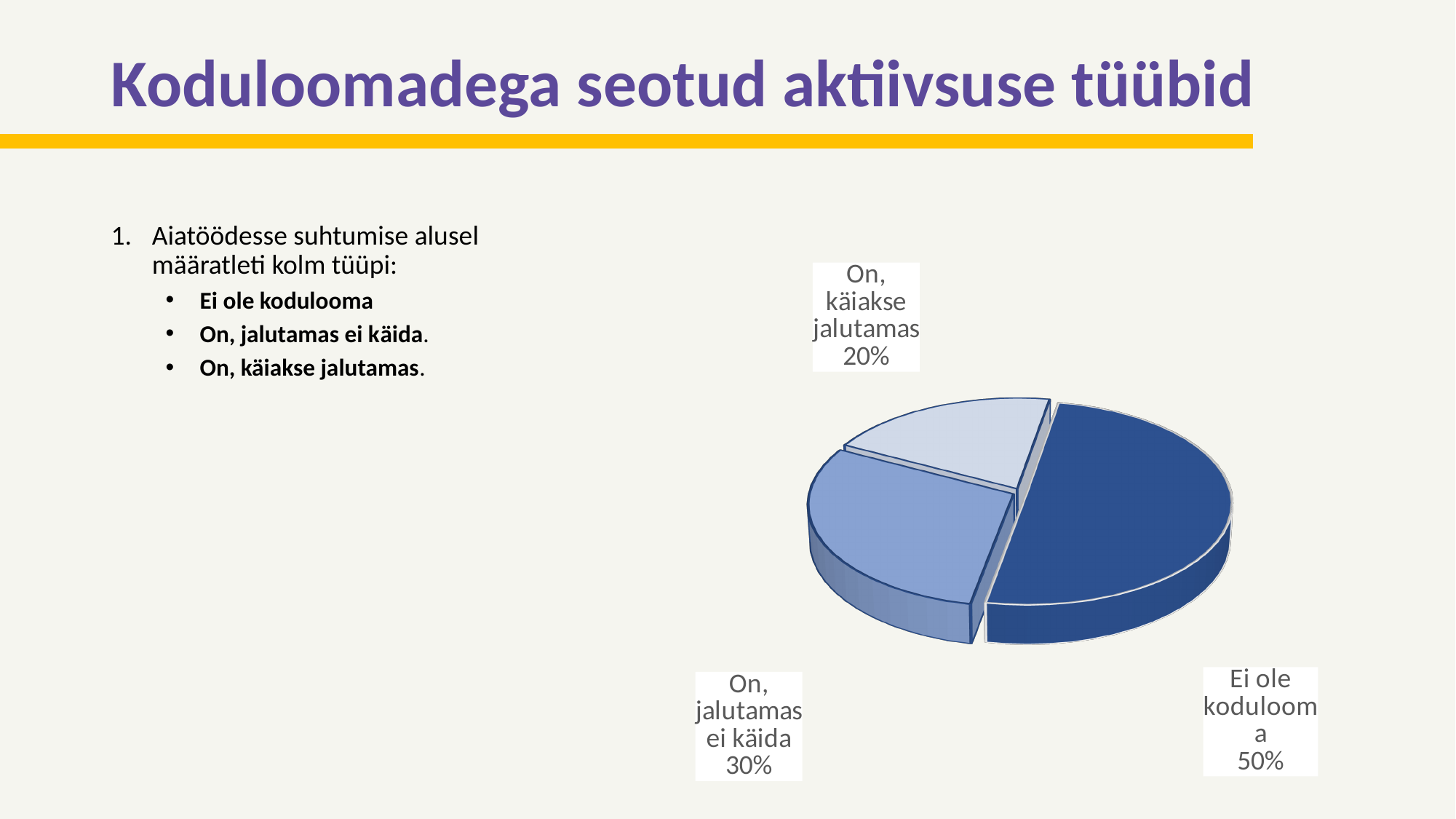
What share of the pie does "Ei ole kodulooma" have? 50% What kind of chart is shown on the slide? pie chart Which slice of the pie is drawn in the darkest blue? Ei ole kodulooma Which slice of the pie is the smallest? On, käiakse jalutamas Which slice of the pie is the largest? Ei ole kodulooma What is the combined share of the two slices for households that have a pet ("On, jalutamas ei käida" and "On, käiakse jalutamas")? 50% How many slices does the pie chart have? 3 What is the difference in percentage points between "On, jalutamas ei käida" and "On, käiakse jalutamas"? 10% Which is larger: the share for "On, jalutamas ei käida" or for "On, käiakse jalutamas"? On, jalutamas ei käida What share of the pie does "On, jalutamas ei käida" have? 30% What is the difference in percentage points between "Ei ole kodulooma" and "On, käiakse jalutamas"? 30% What share of the pie does "On, käiakse jalutamas" have? 20%